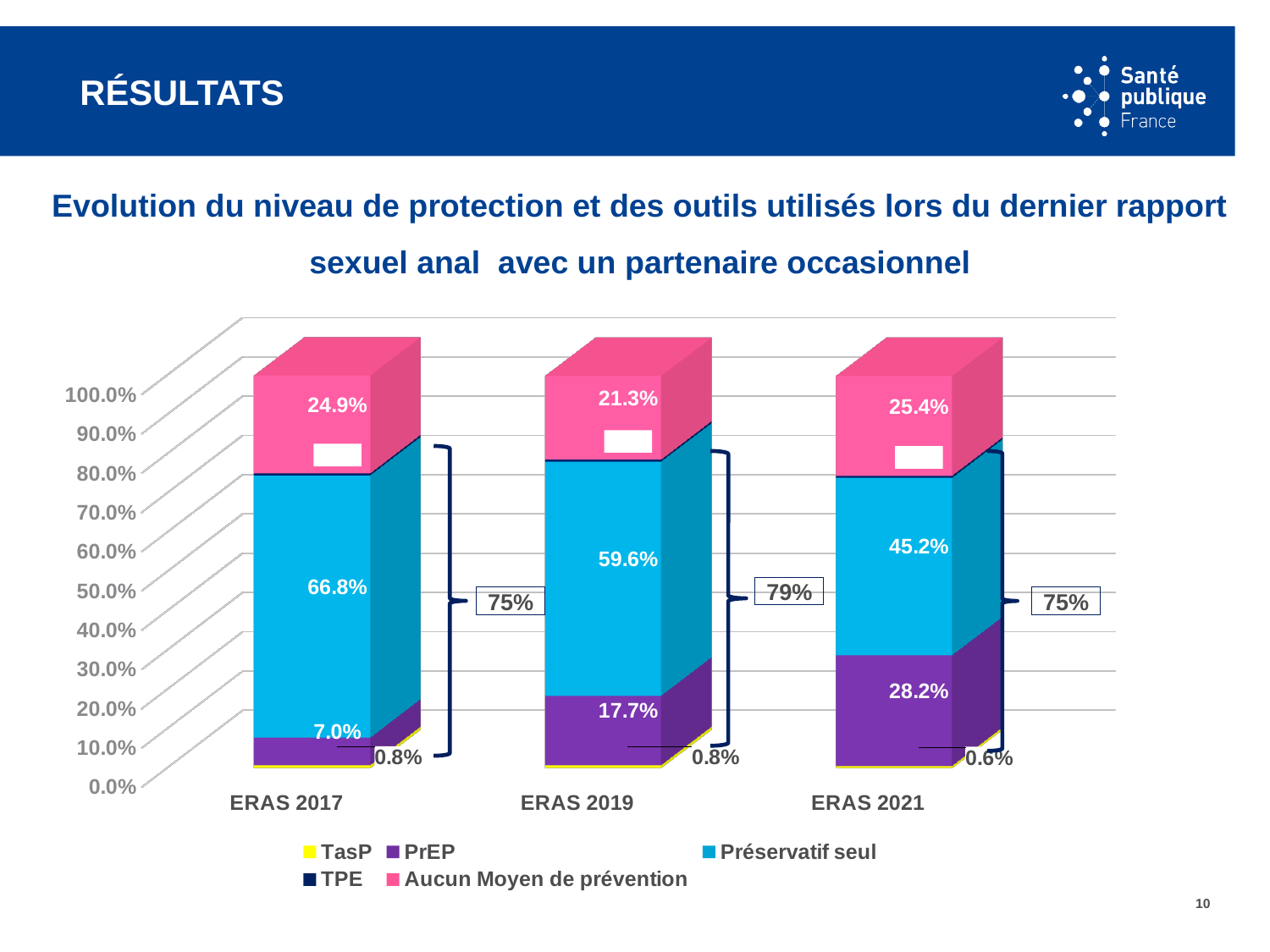
In which survey year is the Préservatif seul value lowest? ERAS 2021 What percentage is shown in the bracket annotation next to the ERAS 2019 bar? 79% What is the value for PrEP in ERAS 2021? 28.2% What is the value for Préservatif seul in ERAS 2017? 66.8% By how many percentage points did the PrEP value increase from ERAS 2017 to ERAS 2021? 21.2 percentage points What is the value for Aucun Moyen de prévention in ERAS 2019? 21.3% Does the PrEP value rise or fall from ERAS 2017 to ERAS 2021? rise How many series does the legend list? 5 How many survey years (categories) are shown on the x axis? 3 Which is larger: the Aucun Moyen de prévention value in ERAS 2017 or in ERAS 2021? ERAS 2021 In which survey year is the PrEP value highest? ERAS 2021 What is the value for PrEP in ERAS 2019? 17.7%